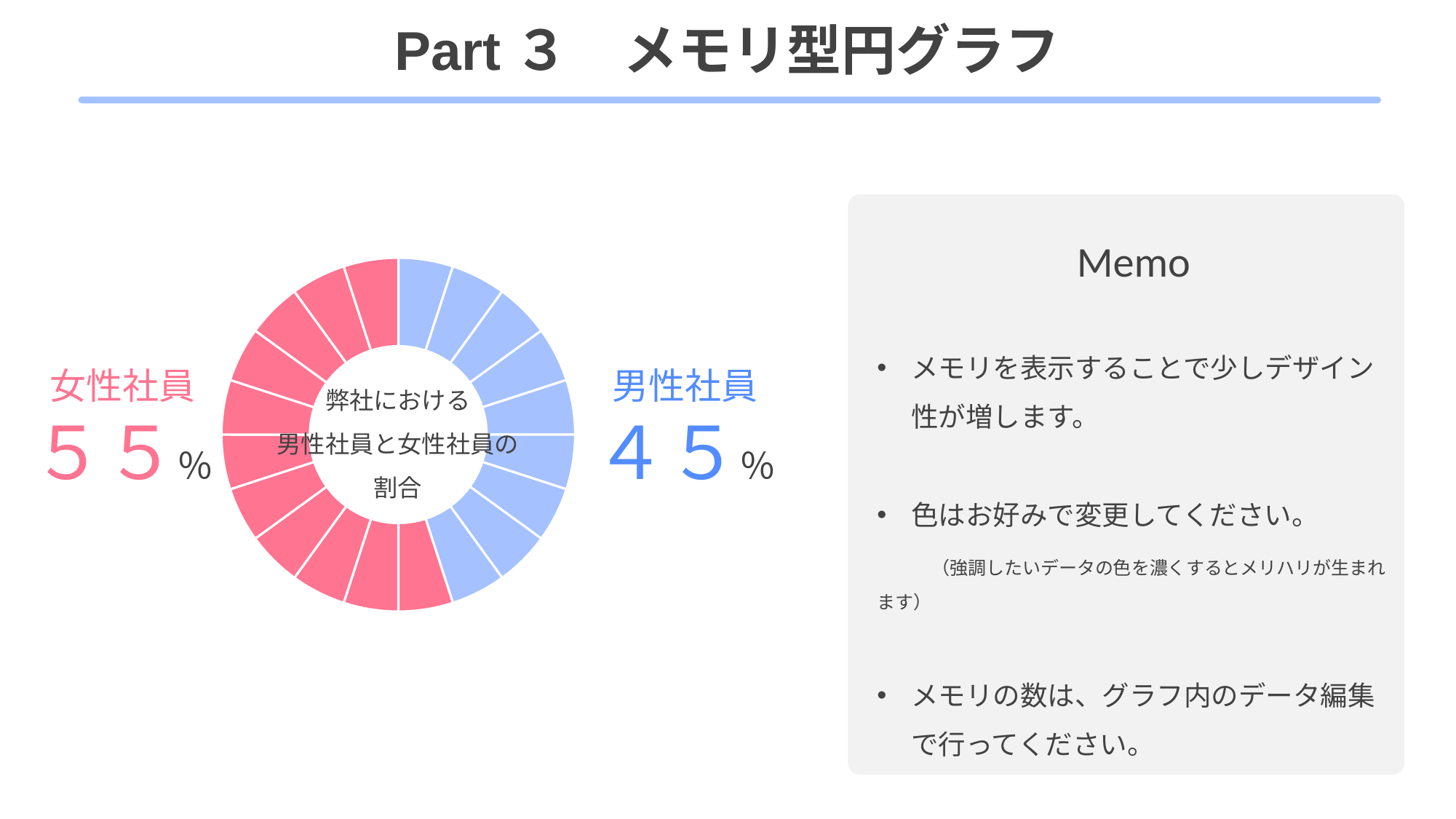
What is the value for 女性社員 (female employees)? 55% Which category has the largest share in the chart? 女性社員 Which category has the smallest share in the chart? 男性社員 What kind of chart is shown on the slide? pie chart (donut) What is the value for 男性社員 (male employees)? 45% What text is written in the centre of the donut chart? 弊社における男性社員と女性社員の割合 What is the total of the two shares shown in the chart? 100% How many categories does the chart show? 2 What colour represents 男性社員 in the chart? blue Which category has the larger share, 女性社員 or 男性社員? 女性社員 What is the difference in percentage points between 女性社員 and 男性社員? 10